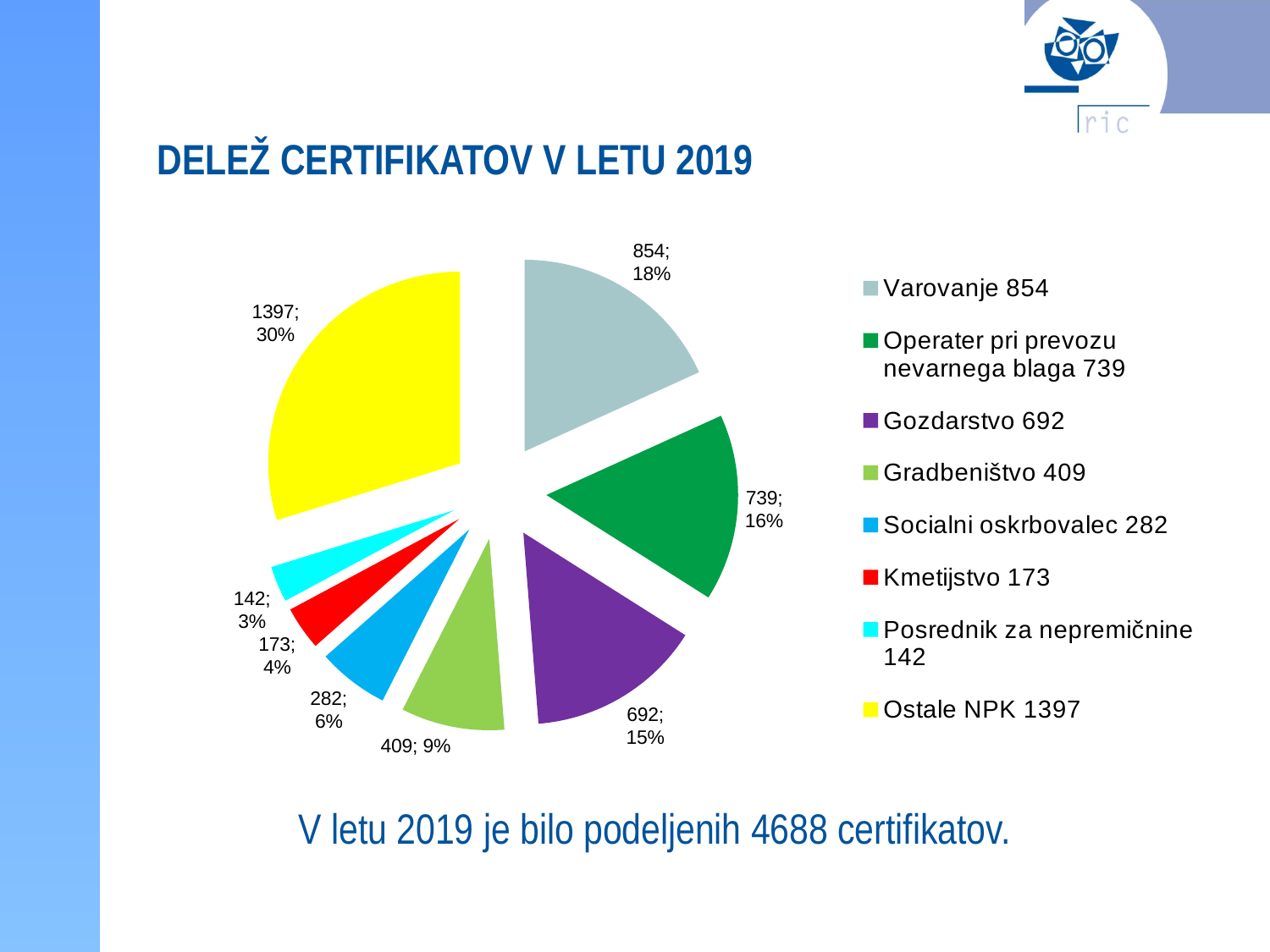
What share of the pie does Ostale NPK represent? 30% Which is larger, the value for Gradbeništvo or the value for Kmetijstvo? Gradbeništvo What is the difference between the values for Varovanje and Operater pri prevozu nevarnega blaga? 115 What kind of chart is shown on the slide? pie chart What is the title of the chart? DELEŽ CERTIFIKATOV V LETU 2019 What is the value for Varovanje? 854 How many slices does the pie chart have? 8 Which category has the smallest slice? Posrednik za nepremičnine What is the value for Gozdarstvo? 692 What colour is the slice for Kmetijstvo? red What share of the pie does Socialni oskrbovalec represent? 6% Which category has the largest slice? Ostale NPK